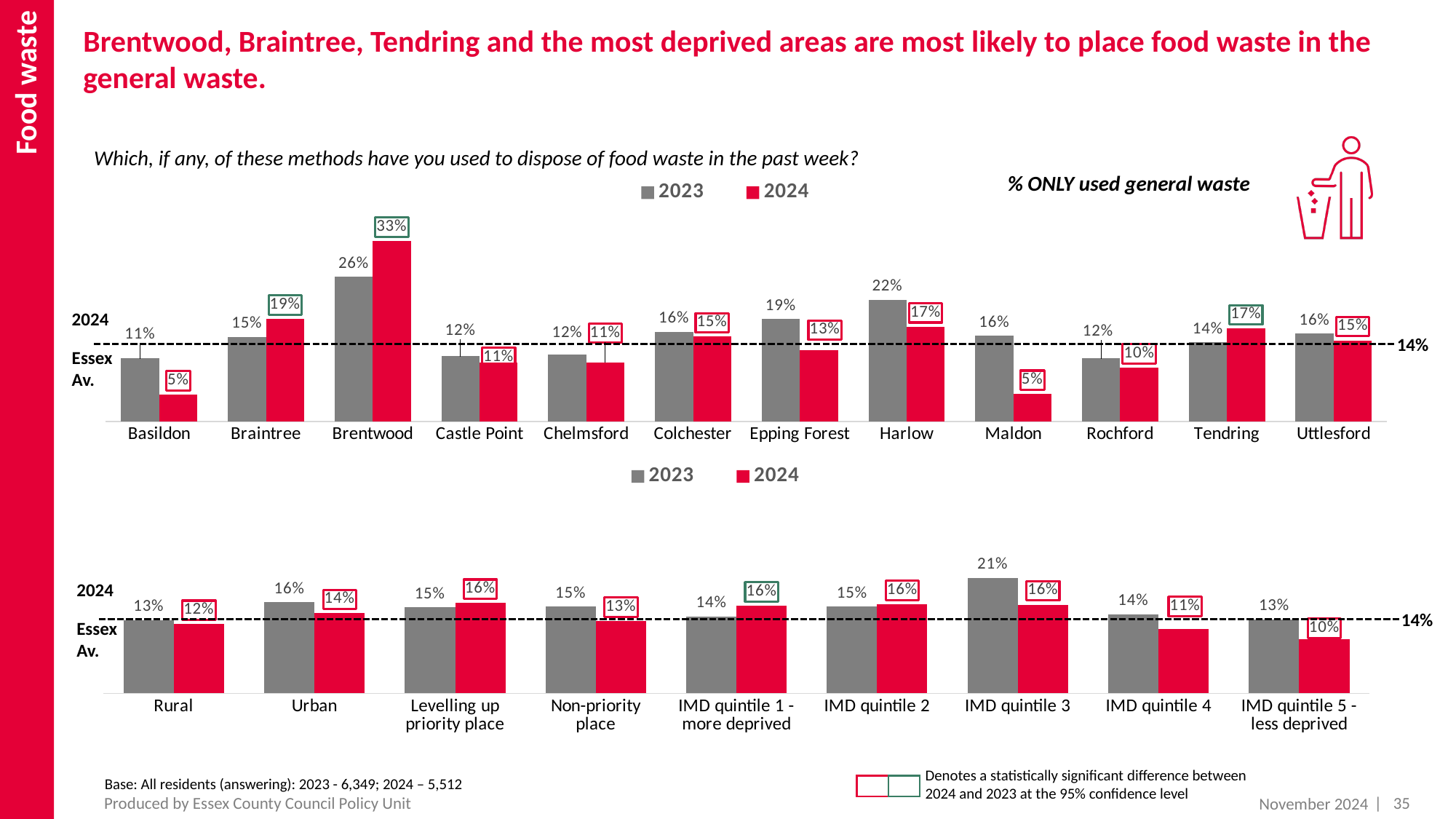
In the top chart (by district), what is the difference between the 2023 and 2024 values for Maldon? 11 percentage points In the top chart (by district), what is the 2024 value for Brentwood? 33% In the bottom chart, which category has the lowest 2024 value? IMD quintile 5 - less deprived In the top chart (by district), is the 2024 value for Braintree or Tendring larger? Braintree In the top chart (by district), which district has the highest 2024 value? Brentwood In the top chart (by district), which districts have the lowest 2024 value? Basildon and Maldon In the top chart (by district), what is the 2023 value for Harlow? 22% In the bottom chart, how many series does the legend list? 2 What is the 2024 Essex average shown by the dashed line on both charts? 14% In the top chart (by district), how many districts are shown on the x axis? 12 In the bottom chart, what is the difference between the 2023 and 2024 values for Urban? 2 percentage points In the bottom chart, what is the 2023 value for IMD quintile 3? 21%